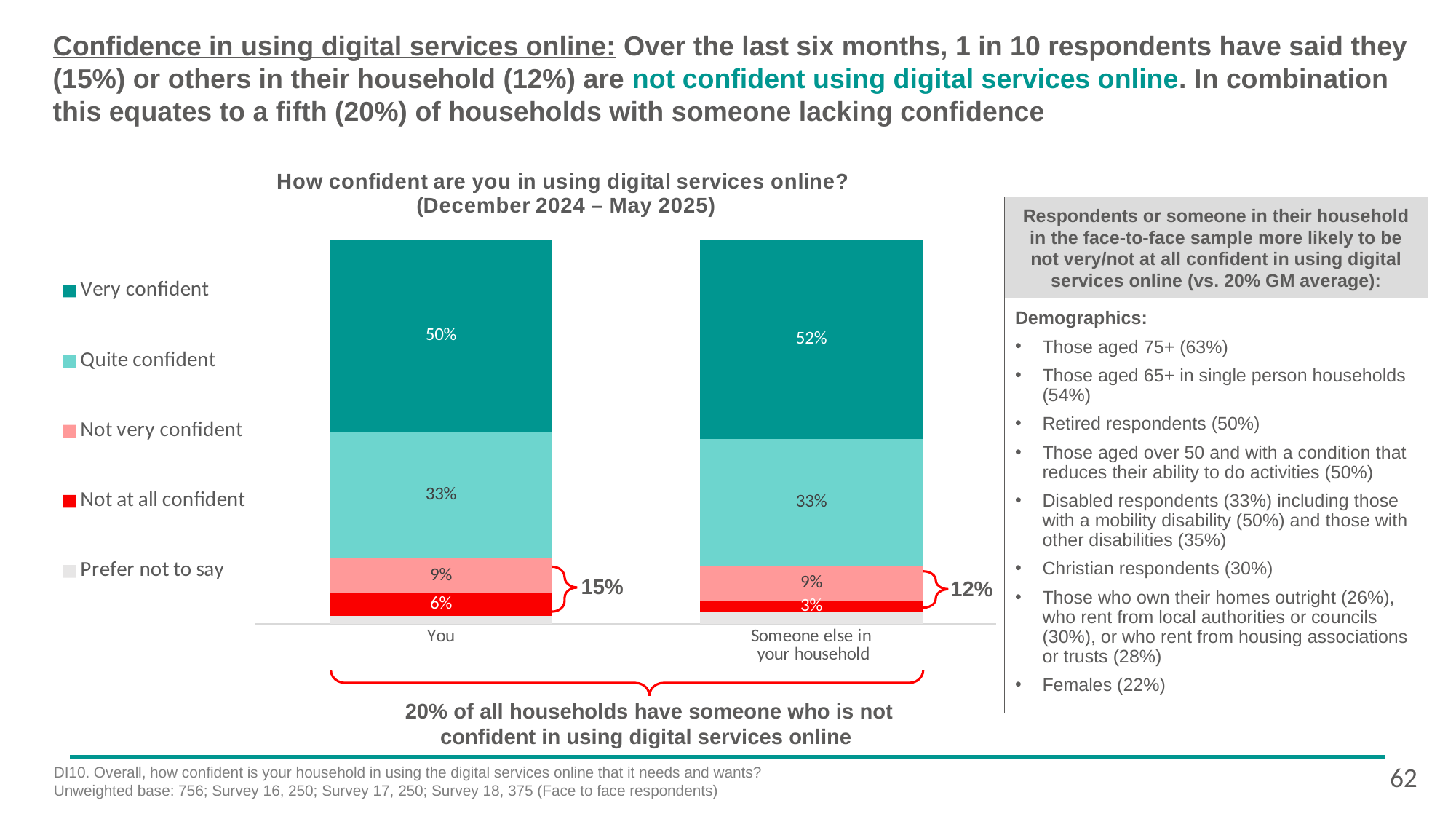
What is the combined 'Not very confident' and 'Not at all confident' share for the 'You' bar, as annotated on the chart? 15% What is the difference between the 'Not at all confident' values for 'You' and 'Someone else in your household'? 3% What is the 'Not at all confident' value for the 'Someone else in your household' bar? 3% Which bar has the higher 'Very confident' value, 'You' or 'Someone else in your household'? Someone else in your household How many series does the chart legend list? 5 What is the combined 'Not very confident' and 'Not at all confident' share for the 'Someone else in your household' bar, as annotated on the chart? 12% What percentage of respondents are 'Very confident' for the 'You' bar? 50% What percentage is shown for 'Very confident' in the 'Someone else in your household' bar? 52% What is the 'Not at all confident' value for the 'You' bar? 6% How many categories are shown on the x axis of the chart? 2 What type of chart is shown on the slide? Stacked bar chart What is the 'Quite confident' value for the 'You' bar? 33%